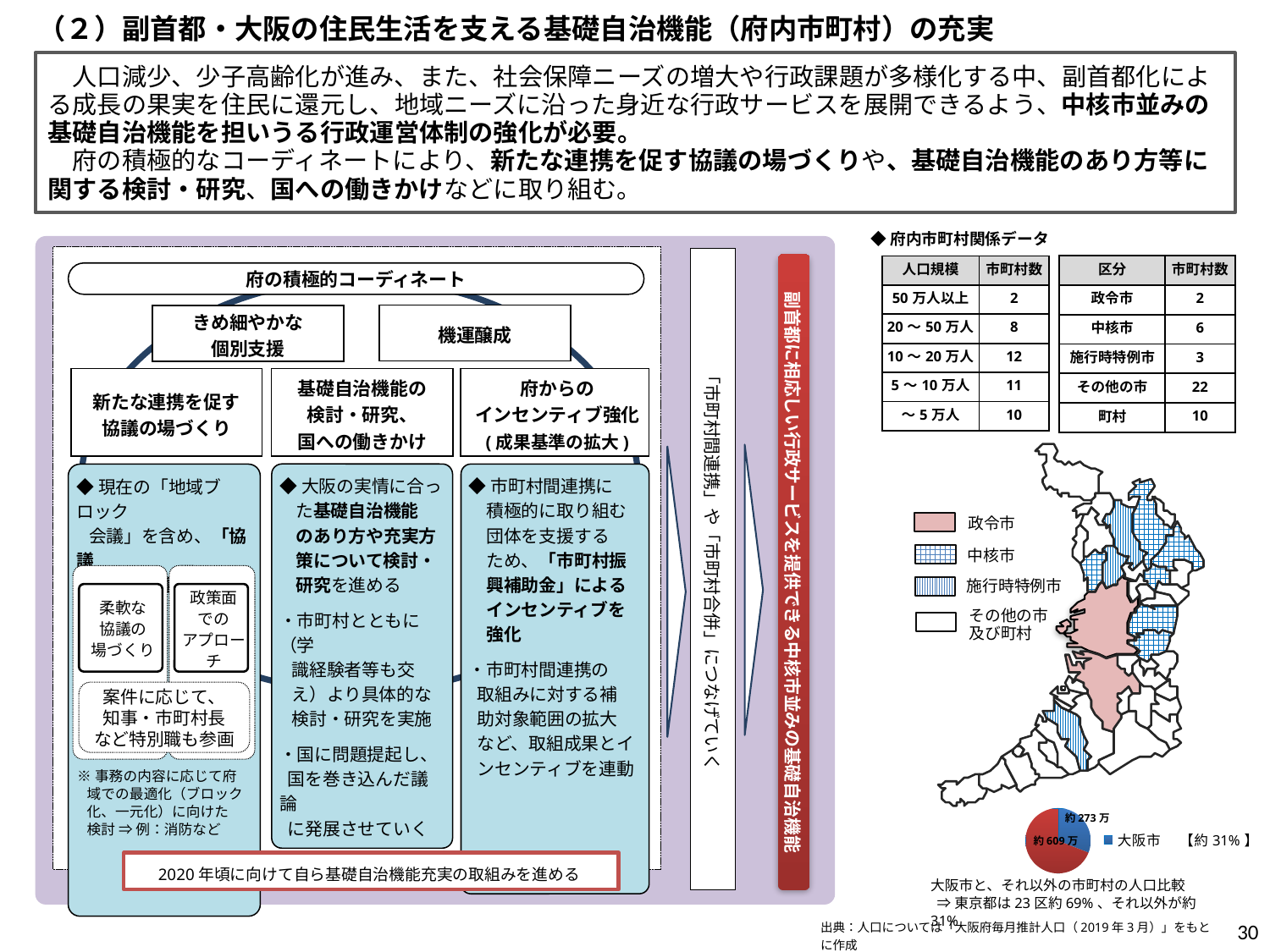
In the pie chart at the bottom right, which slice is larger: 大阪市 or the rest of the municipalities? the rest of the municipalities (約609万) In the pie chart at the bottom right, what population value is labelled for 大阪市? 約273万 In the pie chart at the bottom right, what population value is labelled on the larger slice (the municipalities other than 大阪市)? 約609万 What colour is the 大阪市 slice in the pie chart at the bottom right? blue Which slice is the largest in the pie chart at the bottom right? the municipalities other than 大阪市 (約609万) Which slice is the smallest in the pie chart at the bottom right? 大阪市 How many slices does the pie chart at the bottom right have? 2 According to the pie chart at the bottom right, what share of the population does 大阪市 account for? 約31% What entry is shown in the legend of the pie chart at the bottom right? 大阪市 What kind of chart is shown at the bottom right of the slide comparing the population of 大阪市 with the rest of the prefecture? pie chart